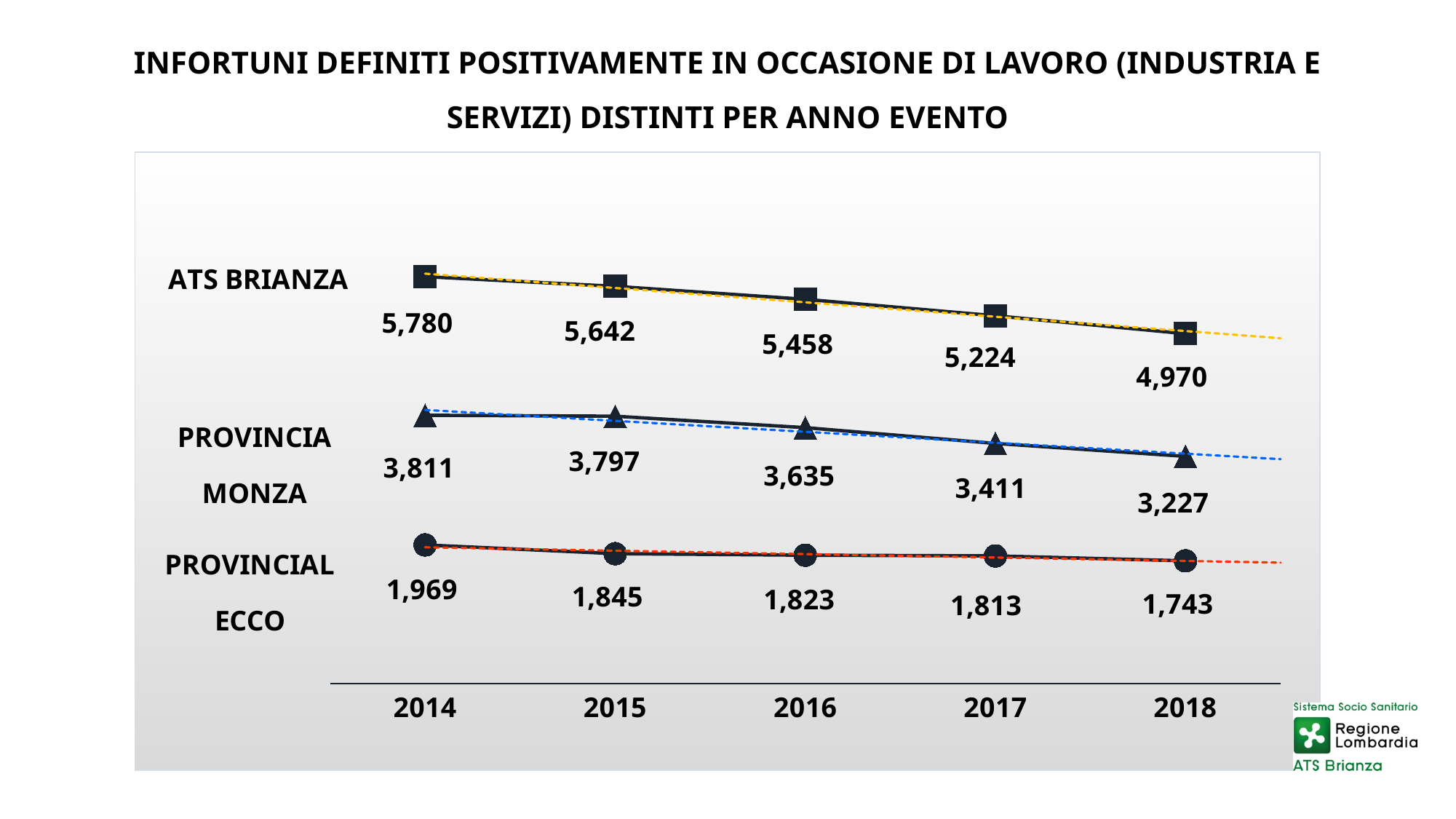
In which year is the value for PROVINCIA MONZA highest? 2014 In which year is the value for PROVINCIA LECCO lowest? 2018 Do the ATS BRIANZA values rise or fall from 2014 to 2018? fall What is the difference between the ATS BRIANZA values in 2014 and 2018? 810 How many years are shown on the x axis? 5 What is the value for ATS BRIANZA in 2014? 5,780 How many series are plotted on the chart? 3 Which is larger, the PROVINCIA MONZA value in 2015 or the PROVINCIA LECCO value in 2015? PROVINCIA MONZA What is the value for PROVINCIA MONZA in 2016? 3,635 What is the difference between the PROVINCIA MONZA and PROVINCIA LECCO values in 2017? 1,598 What is the value for ATS BRIANZA in 2018? 4,970 What is the value for PROVINCIA LECCO in 2018? 1,743